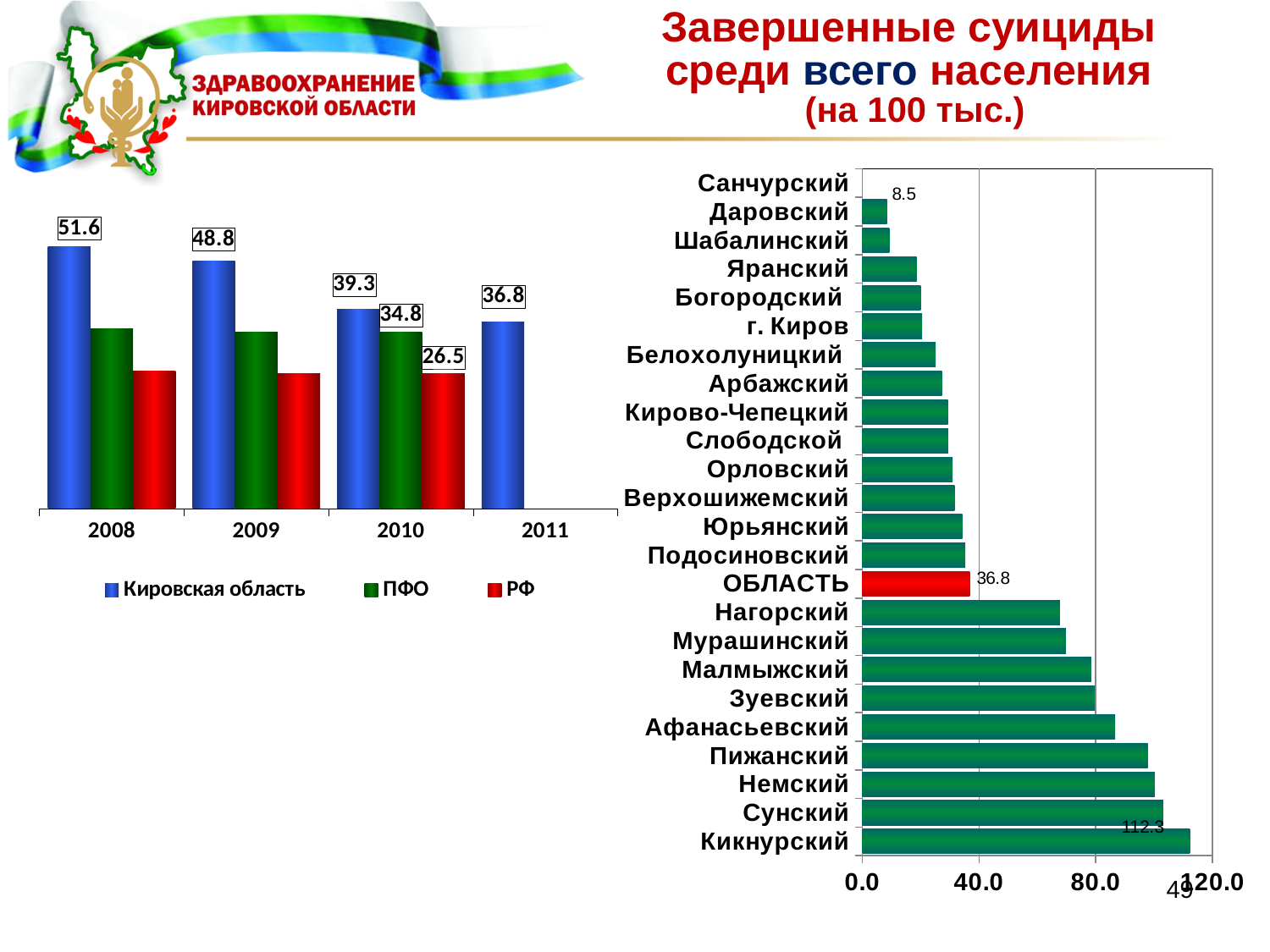
In the left chart, what is the difference between Кировская область and РФ in 2010? 12.8 In the right chart, what is the value for Кикнурский? 112.3 In the left chart, what is the value for Кировская область in 2008? 51.6 In the right chart, which district has the highest value? Кикнурский In the right chart, is the value for Нагорский greater or less than 40.0? greater In the left chart, which is larger for Кировская область: 2008 or 2011? 2008 What kind of chart is the chart on the right side of the slide? bar chart In the left chart, do the values for Кировская область rise or fall from 2008 to 2011? fall In the left chart, how many series does the legend list? 3 In the left chart, what is the value for ПФО in 2010? 34.8 In the left chart, what is the value for РФ in 2010? 26.5 In the right chart, what is the value for ОБЛАСТЬ? 36.8